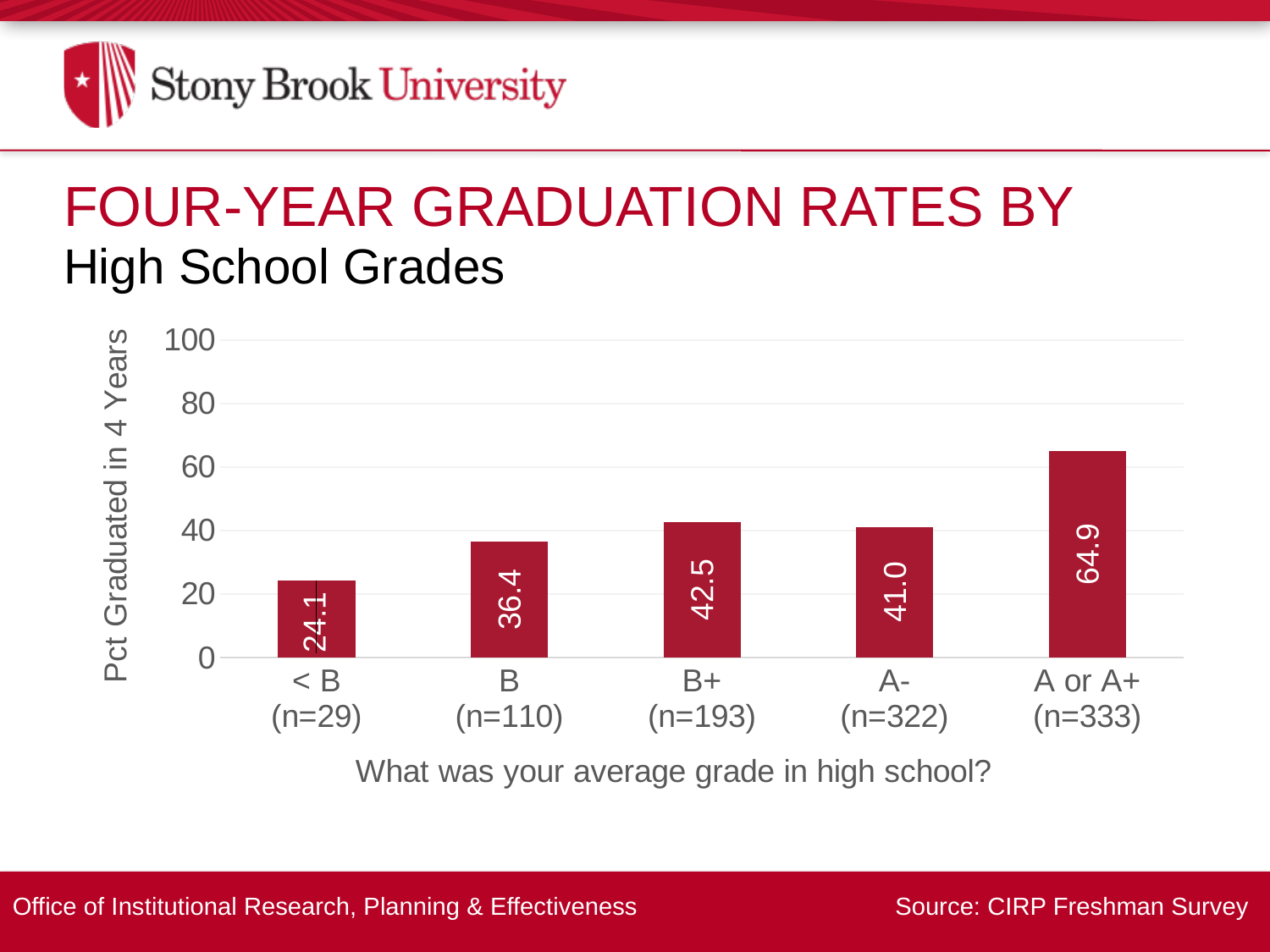
What kind of chart is shown on the slide? bar chart Which high school grade category has the lowest four-year graduation rate? < B Which group has a higher four-year graduation rate, B+ or A-? B+ What is the label of the vertical axis? Pct Graduated in 4 Years What is the sample size (n) for the A- group? 322 What is the difference in four-year graduation rate between the A or A+ group and the < B group? 40.8 What is the four-year graduation rate for students with an average high school grade below B (< B)? 24.1 What is the four-year graduation rate for students with an average high school grade of B+? 42.5 Which high school grade category has the highest four-year graduation rate? A or A+ What is the four-year graduation rate for students with an average high school grade of A or A+? 64.9 How many high school grade categories are shown on the chart? 5 Is the four-year graduation rate for the B group greater or less than 40? less